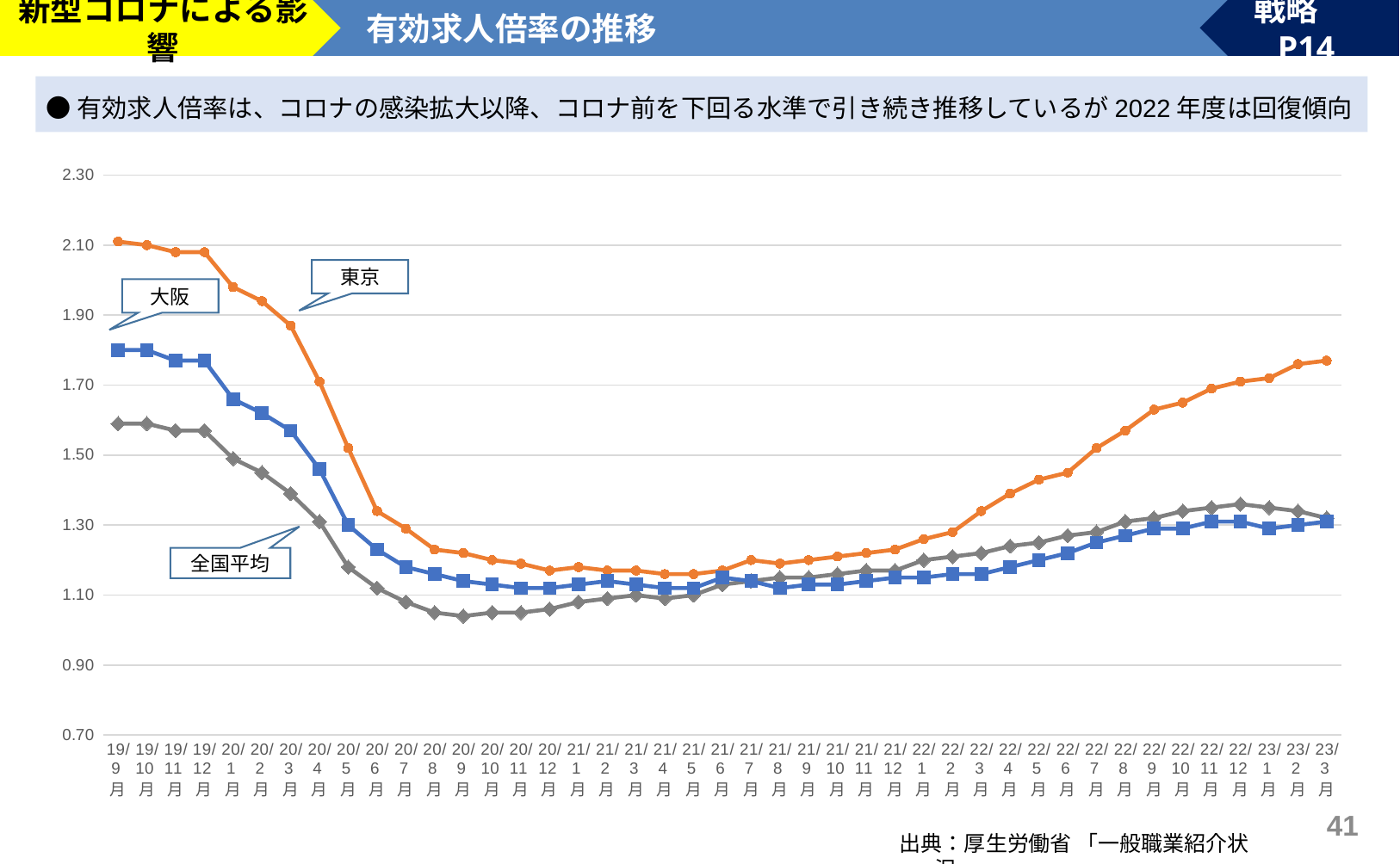
Does the 東京 series rise or fall from 19/9月 to 20/9月? fall Is the value for 大阪 at 19/9月 greater or less than 1.70? greater How many monthly points are plotted along the x axis for each series? 43 How many series are plotted in the chart? 3 Which series has the lowest value at 19/9月? 全国平均 Is the value for 東京 at 23/3月 greater or less than 1.70? greater What is the title of the chart? 有効求人倍率の推移 Which series is larger at 23/3月, 東京 or 大阪? 東京 Is the value for 全国平均 at 20/9月 greater or less than 1.10? less What kind of chart is shown on the slide? line chart Which series has the highest value at 19/9月? 東京